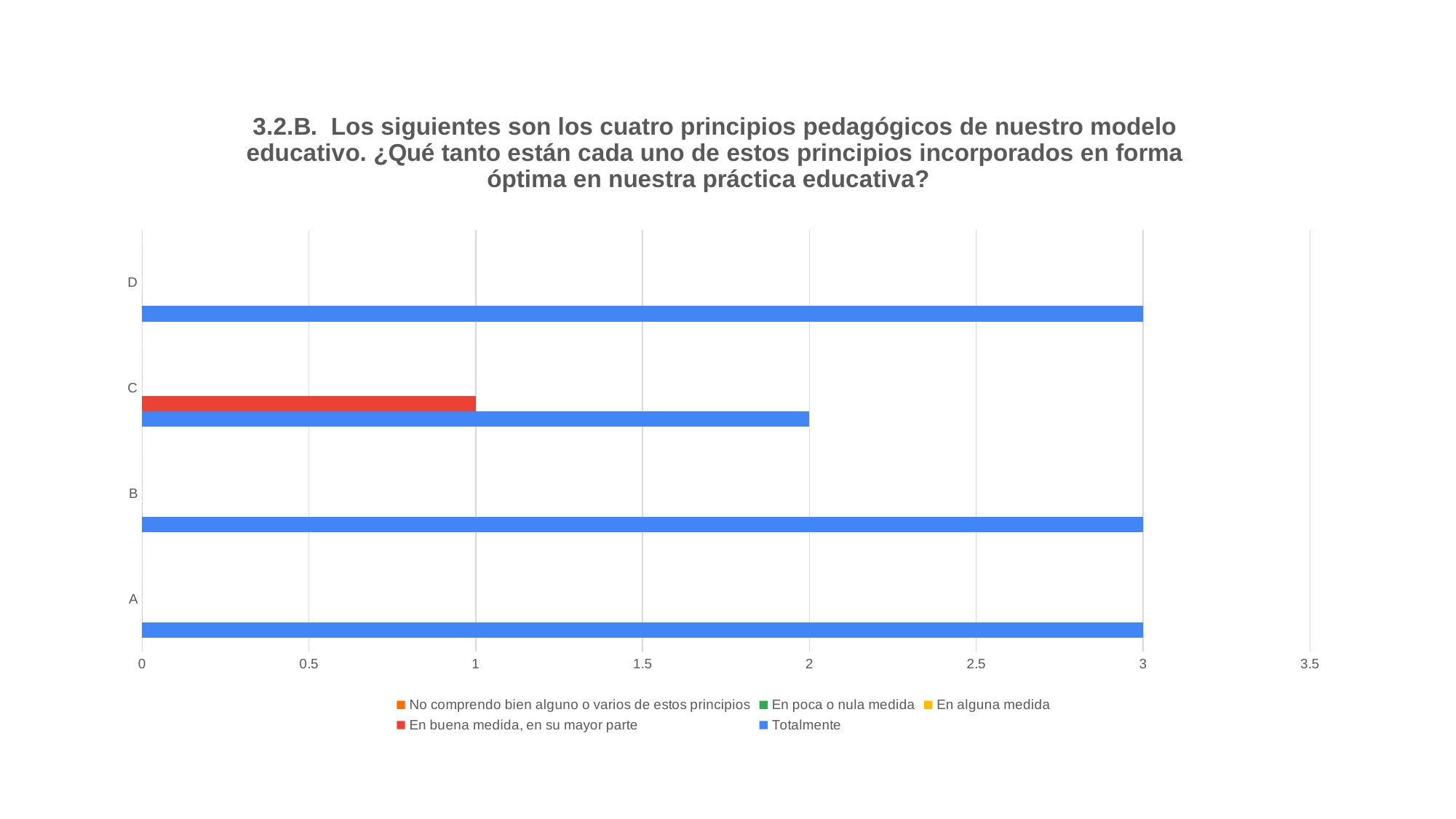
For category C, which is larger: the "Totalmente" value or the "En buena medida, en su mayor parte" value? Totalmente What colour are the bars for the "Totalmente" series? blue Which category has the lowest value for the "Totalmente" series? C What kind of chart is shown on the slide? bar chart What is the value of the "Totalmente" series for category A? 3 What is the value of the "Totalmente" series for category C? 2 Which category is the only one with a visible bar for the "En buena medida, en su mayor parte" series? C Is the "Totalmente" value for category D greater or less than 2.5? greater What is the value of the "En buena medida, en su mayor parte" series for category C? 1 How many series does the legend list? 5 What is the difference between the "Totalmente" value for category B and the "Totalmente" value for category C? 1 How many categories are shown on the vertical axis? 4